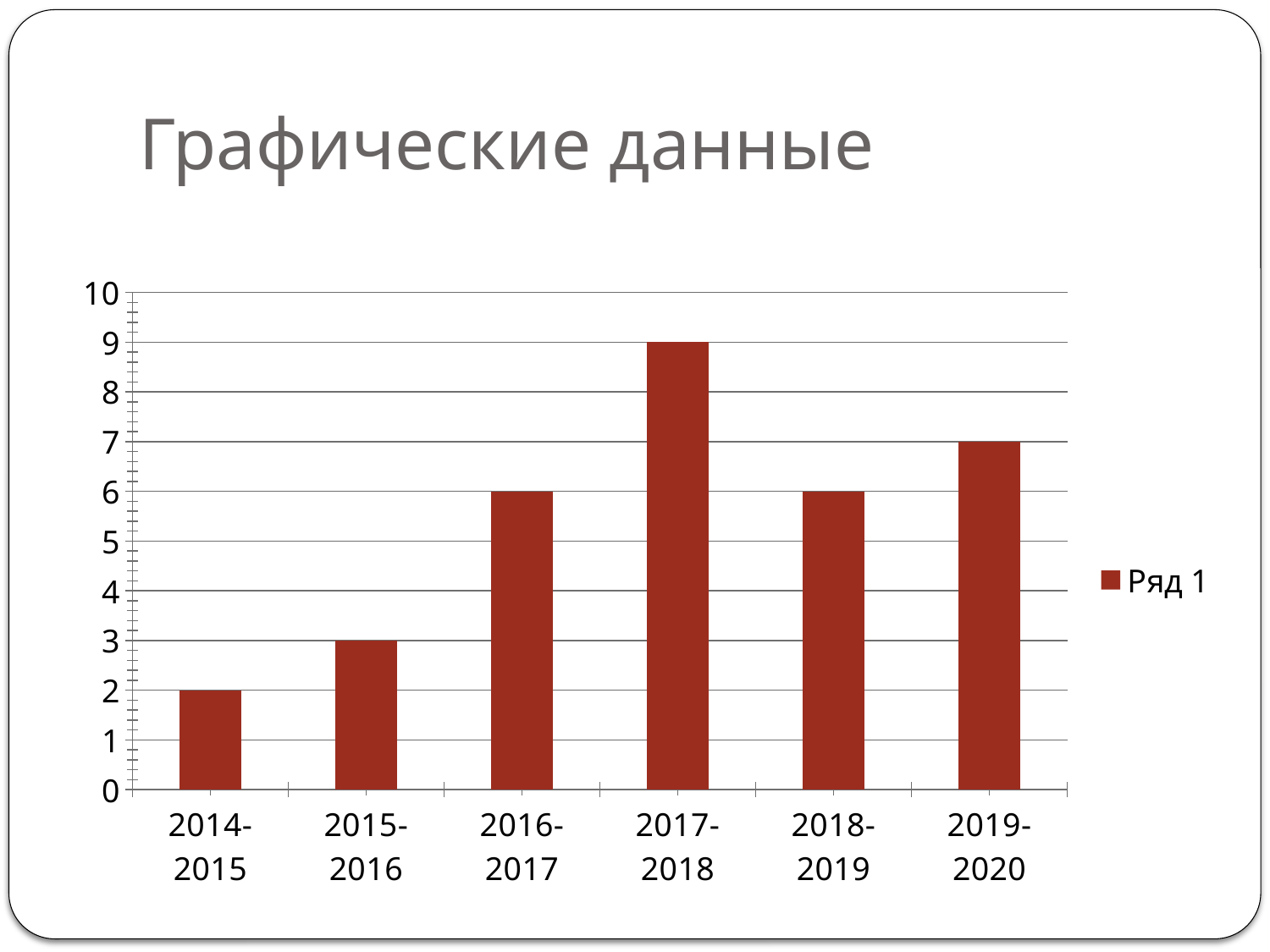
Which is larger, the value for 2019-2020 or the value for 2016-2017? 2019-2020 Which period has the highest value? 2017-2018 How many periods are shown on the x axis? 6 What kind of chart is shown on the slide? bar chart Which period has the lowest value? 2014-2015 What is the difference between the values for 2017-2018 and 2014-2015? 7 What is the value for 2014-2015? 2 How many series does the legend list? 1 Is the value for 2015-2016 greater or less than 5? less What is the value for 2017-2018? 9 What is the title of the slide? Графические данные What is the value for 2019-2020? 7